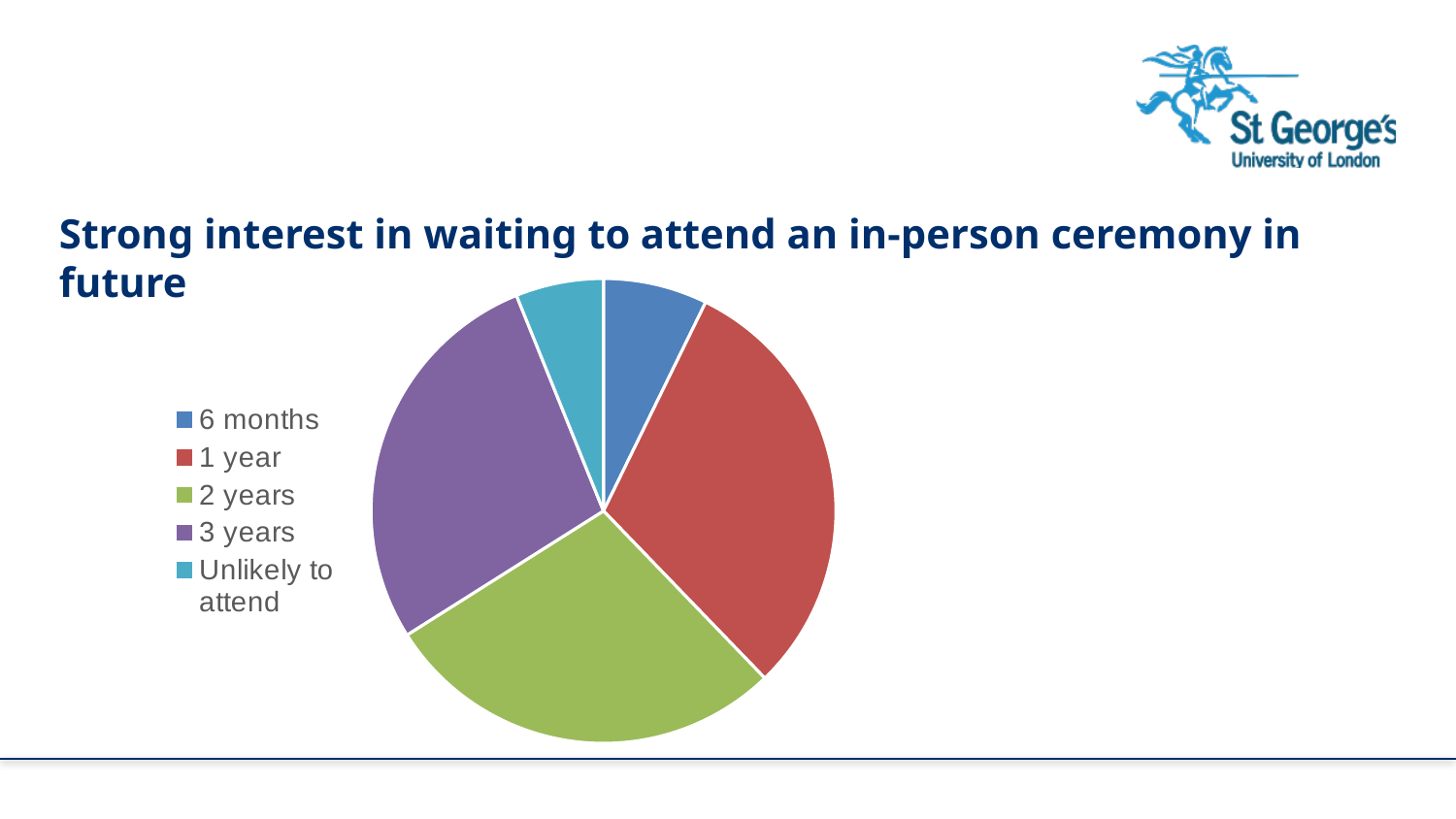
What is the title of the slide containing the pie chart? Strong interest in waiting to attend an in-person ceremony in future Which slice is larger, 2 years or Unlikely to attend? 2 years Which slice is larger, 2 years or 6 months? 2 years Which slice is larger, 3 years or 6 months? 3 years What kind of chart is shown on the slide? pie chart How many entries does the legend of the pie chart list? 5 What colour is the 1 year slice in the pie chart? red How many slices does the pie chart have? 5